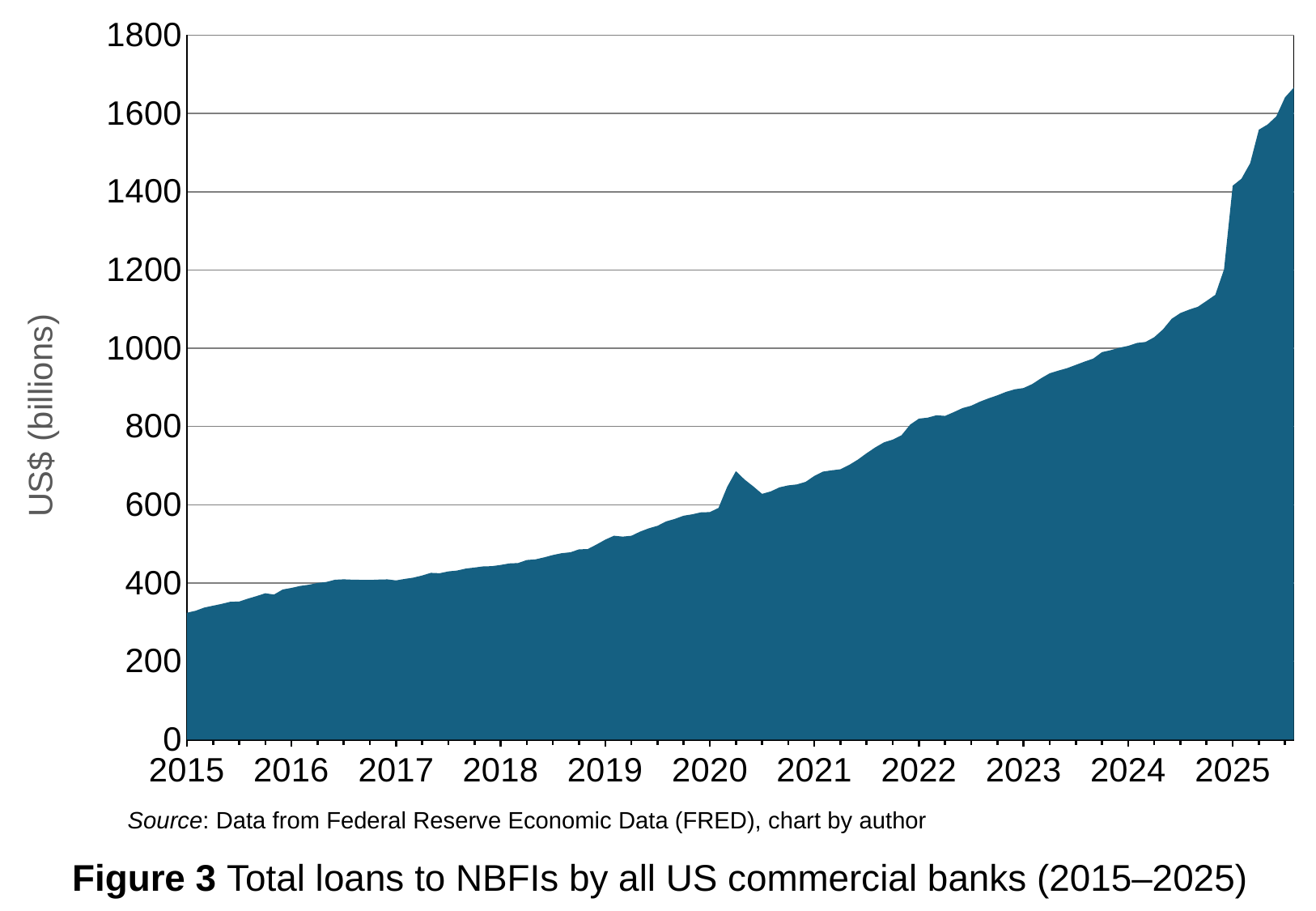
Is the value at the start of 2021 greater or less than 600? greater Is the value at the start of 2022 greater or less than 1000? less Is the value at the start of 2015 greater or less than 400? less Do the values in the chart generally rise or fall from 2015 to 2025? Rise What is the title of the figure shown on the slide? Figure 3 Total loans to NBFIs by all US commercial banks (2015–2025) Which is larger, the value at the start of 2019 or the value at the start of 2024? 2024 What is the label on the vertical axis of the chart? US$ (billions) What kind of chart is shown on the slide? Area chart